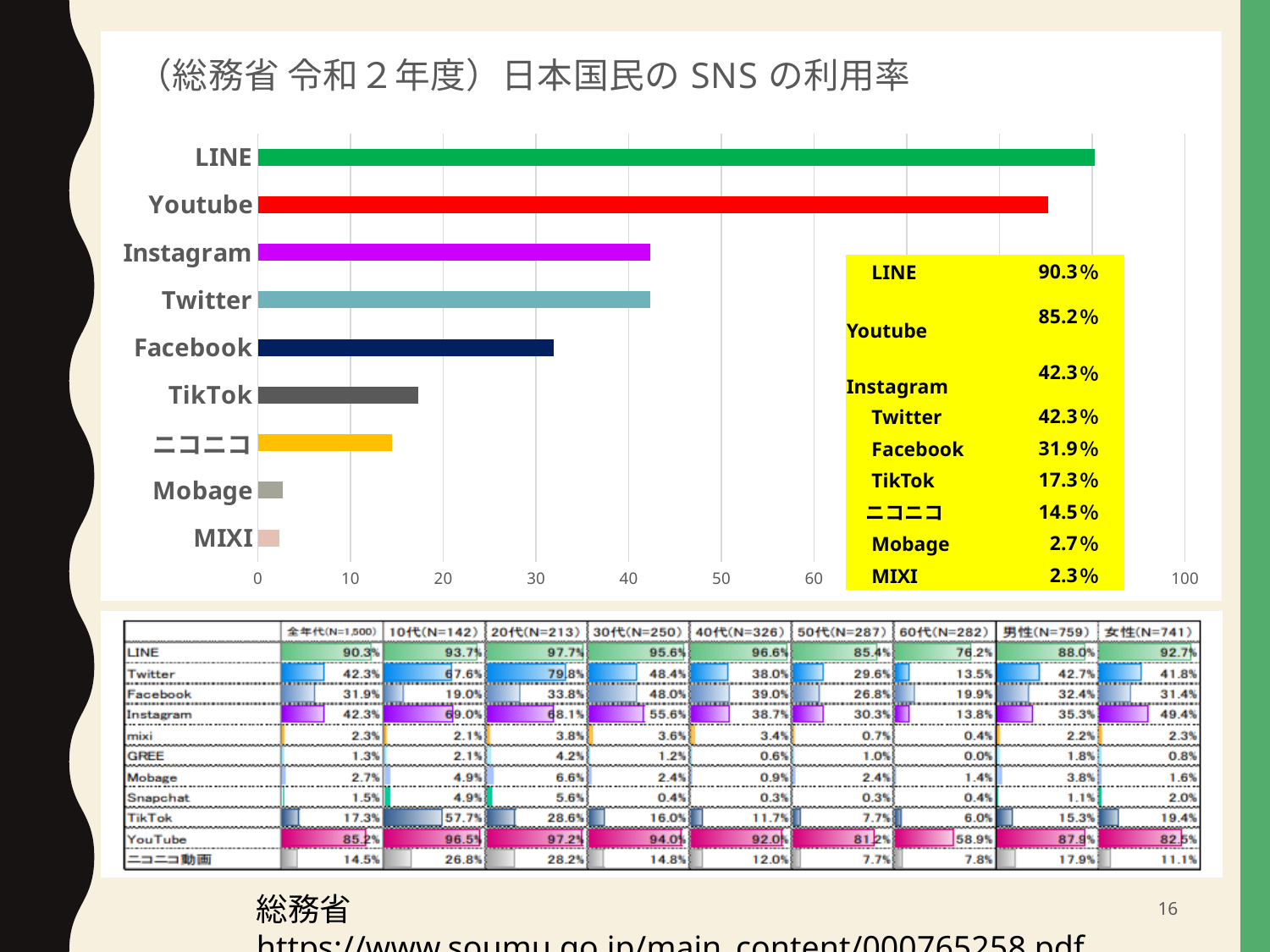
Which has a higher usage rate, Youtube or Instagram? Youtube What is the difference between the usage rates of LINE and Youtube? 5.1% What is the usage rate for LINE? 90.3% What type of chart is shown on the slide? bar chart Is the value for Facebook greater or less than 40? less What is the usage rate for Facebook? 31.9% What is the usage rate for ニコニコ? 14.5% Which SNS has the lowest usage rate? MIXI Which SNS has the highest usage rate? LINE What is the usage rate for TikTok? 17.3% What is the difference between the usage rates of Facebook and TikTok? 14.6% How many SNS categories are shown in the bar chart? 9